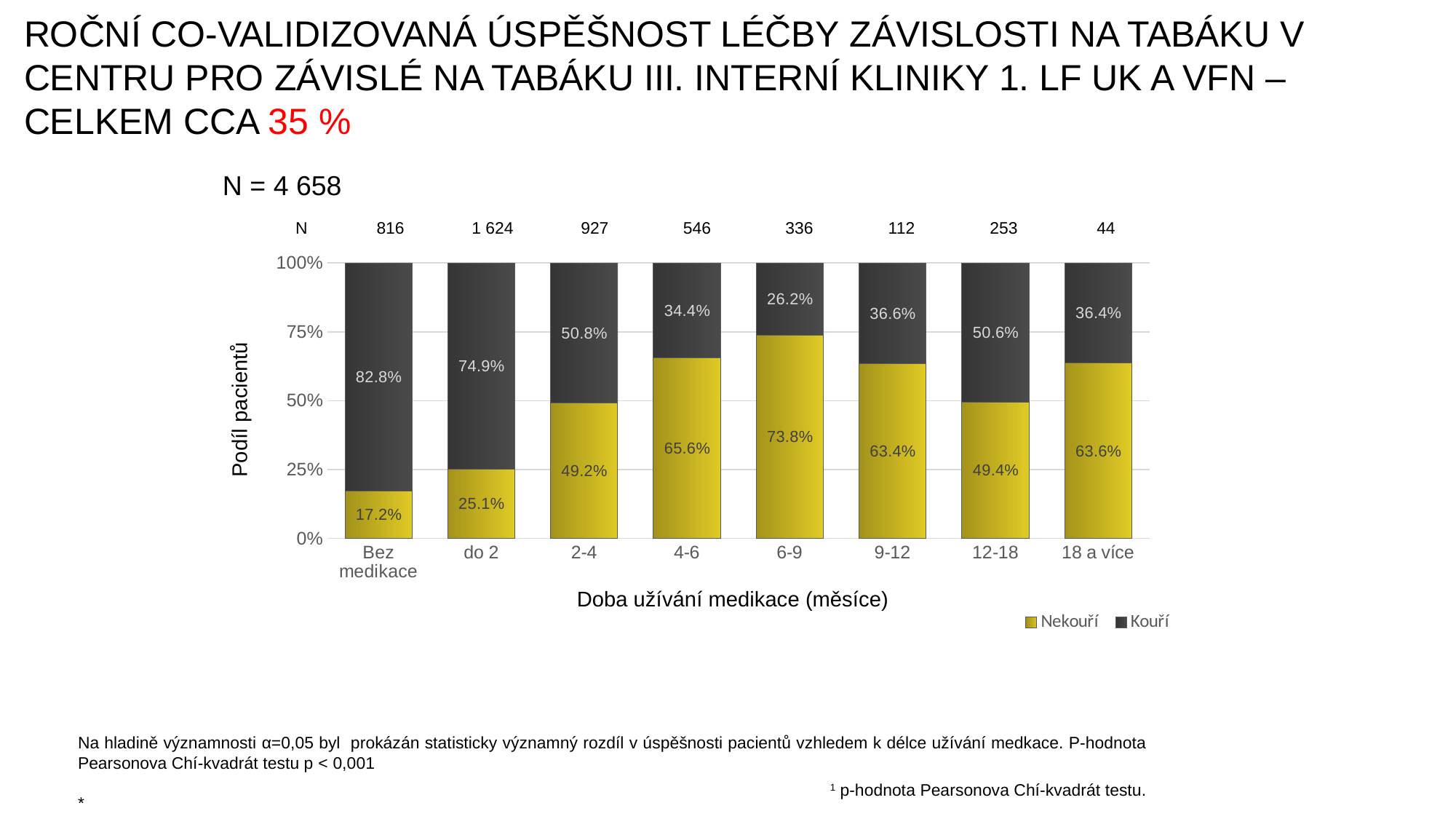
Which is larger, the Nekouří value for 9-12 or for 18 a více? 18 a více Which category has the lowest Nekouří value? Bez medikace What is the Nekouří value for the 6-9 category? 73.8% How many series does the legend list? 2 What is the difference between the Nekouří values for 4-6 and do 2? 40.5% Which category has the highest Nekouří value? 6-9 How many categories are shown on the x axis? 8 What is the label of the x axis? Doba užívání medikace (měsíce) What is the Kouří value for the Bez medikace category? 82.8% What is the Nekouří value for the 12-18 category? 49.4% What kind of chart is shown on the slide? Stacked bar chart What is the N value shown above the 2-4 category? 927